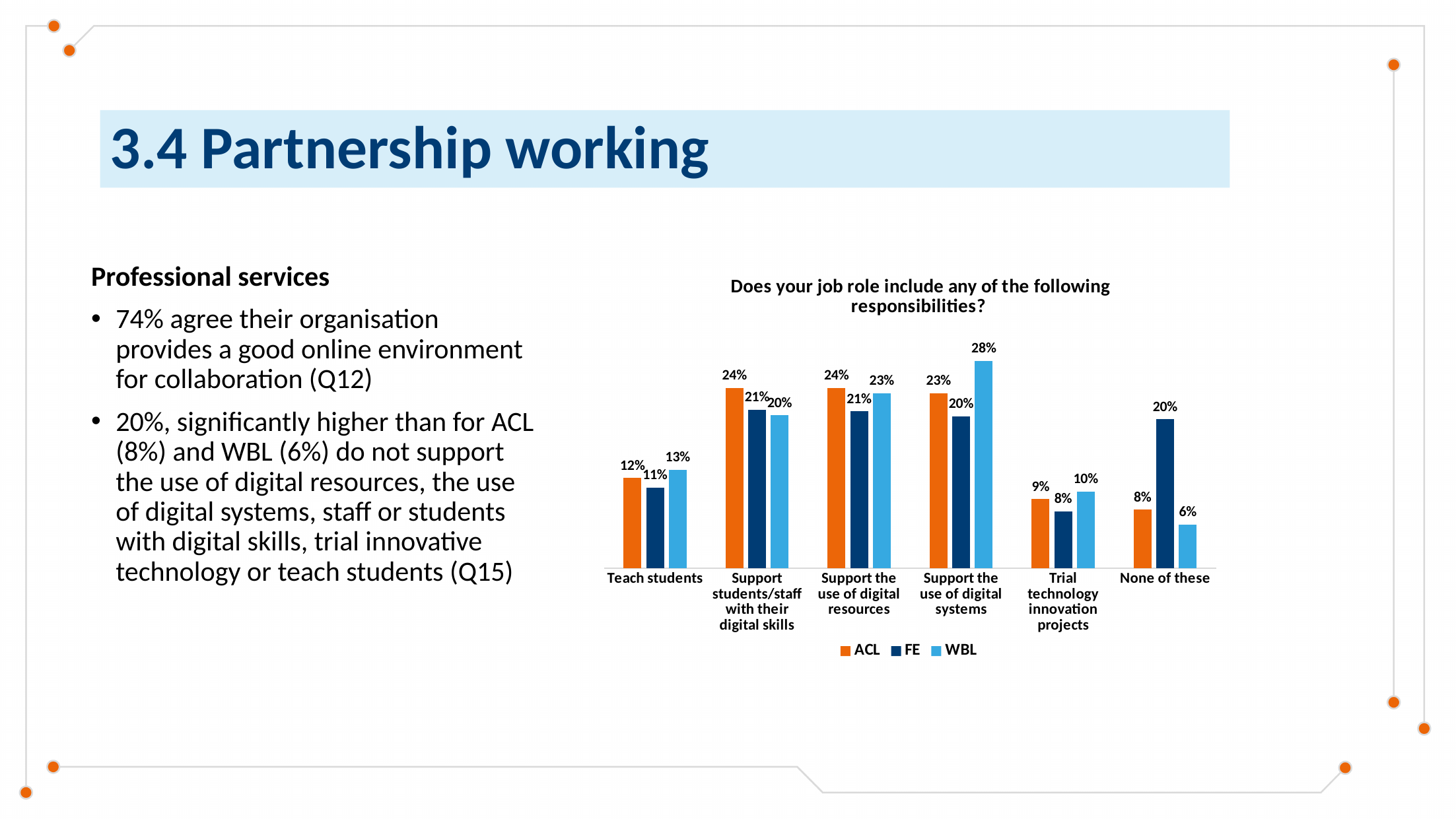
Which category has the lowest FE value? Trial technology innovation projects What is the difference between the FE and WBL values in the 'None of these' category? 14% What is the title of the chart? Does your job role include any of the following responsibilities? What is the value for WBL in the 'Support the use of digital systems' category? 28% Which category has the highest WBL value? Support the use of digital systems What is the value for FE in the 'None of these' category? 20% What is the value for ACL in the 'Teach students' category? 12% How many series does the legend list? 3 Which is larger in the 'Support the use of digital resources' category, ACL or FE? ACL How many categories are shown on the x axis? 6 Which series is shown in orange in the legend? ACL What kind of chart is shown on the slide? Bar chart